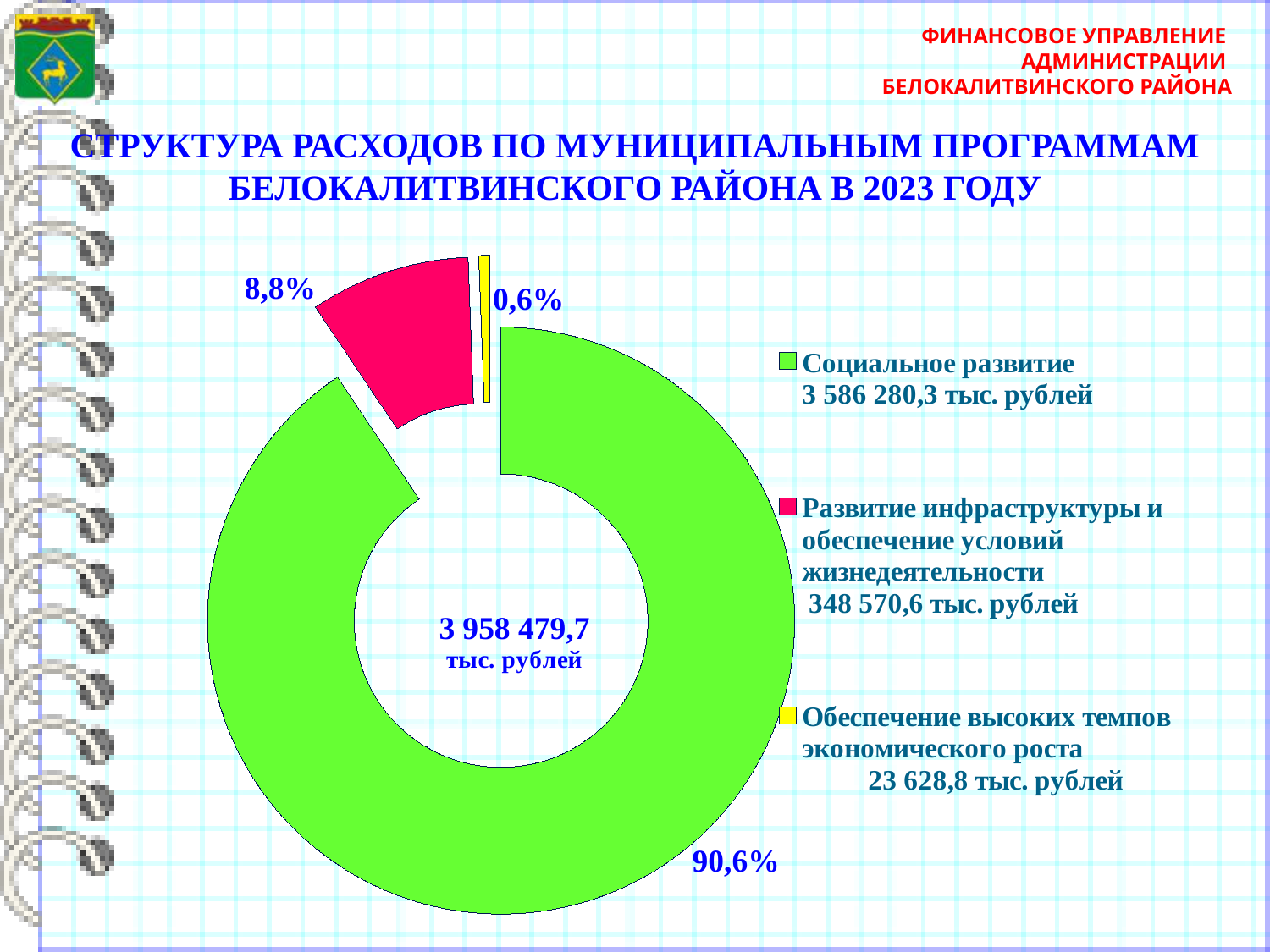
What share of the expenditure does Обеспечение высоких темпов экономического роста account for? 0,6% What kind of chart is shown on the slide? doughnut (pie) chart What is the value for Социальное развитие? 3 586 280,3 тыс. рублей What is the difference between the values for Социальное развитие and Развитие инфраструктуры и обеспечение условий жизнедеятельности? 3 237 709,7 тыс. рублей Which programme has the largest share of expenditure? Социальное развитие How many programmes (slices) does the chart show? 3 What is the value for Обеспечение высоких темпов экономического роста? 23 628,8 тыс. рублей What share of the expenditure does Социальное развитие account for? 90,6% What is the total expenditure shown in the centre of the chart? 3 958 479,7 тыс. рублей What share of the expenditure does Развитие инфраструктуры и обеспечение условий жизнедеятельности account for? 8,8% Which programme has the smallest share of expenditure? Обеспечение высоких темпов экономического роста What is the value for Развитие инфраструктуры и обеспечение условий жизнедеятельности? 348 570,6 тыс. рублей